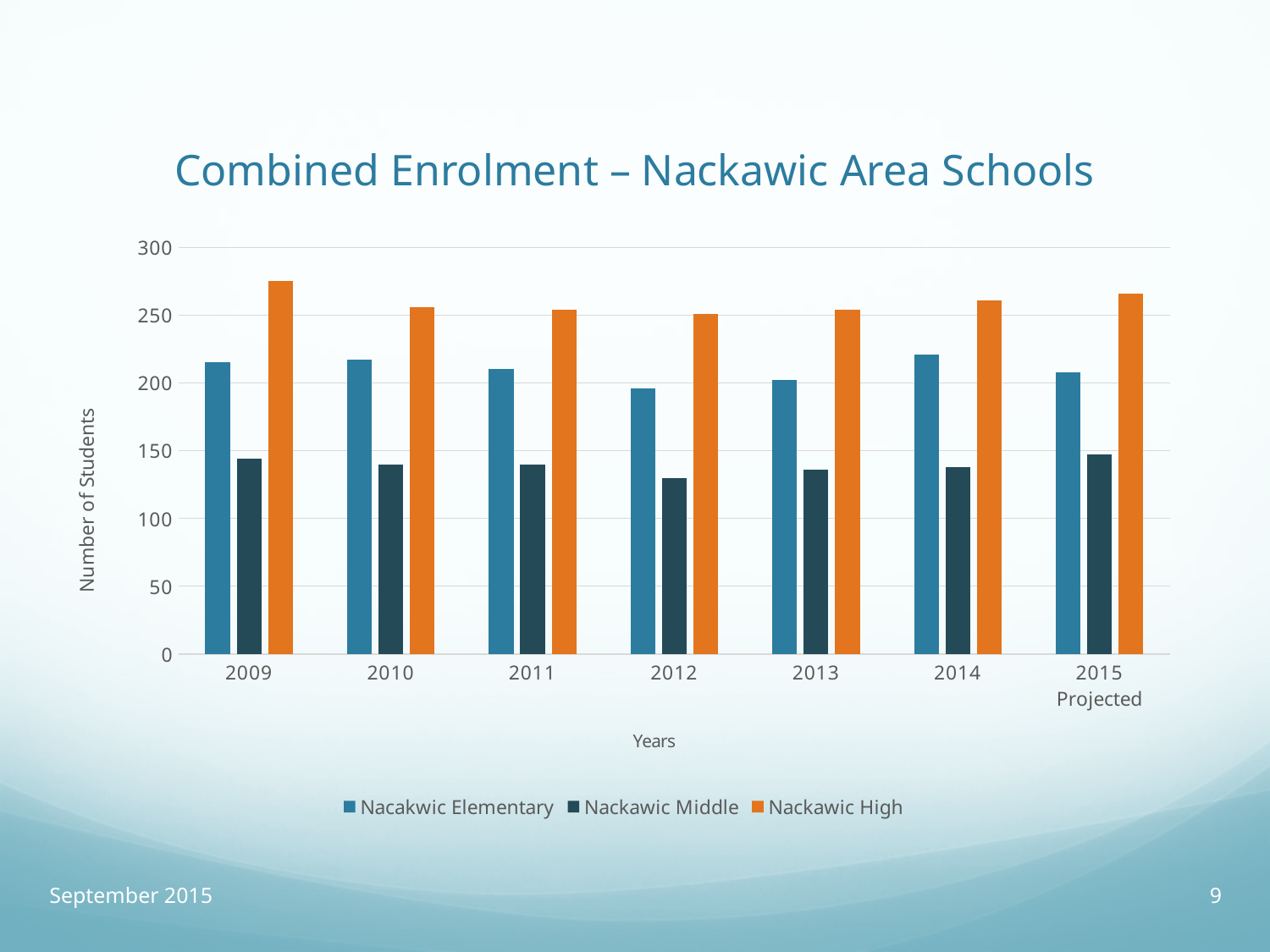
How many year categories are shown on the x axis? 7 Which is larger in 2015 Projected: Nackawic High or Nacakwic Elementary? Nackawic High What type of chart is shown on the slide? bar chart Is the value for Nackawic Middle in 2012 greater or less than 150? less How many series does the legend list? 3 In which year is the Nackawic High enrolment highest? 2009 Is the value for Nacakwic Elementary in 2014 greater or less than 200? greater Which is larger in 2013: Nacakwic Elementary or Nackawic Middle? Nacakwic Elementary What is the label on the vertical axis? Number of Students What is the title of the chart? Combined Enrolment – Nackawic Area Schools Is the value for Nackawic High in 2009 greater or less than 250? greater In which year is the Nackawic Middle enrolment lowest? 2012